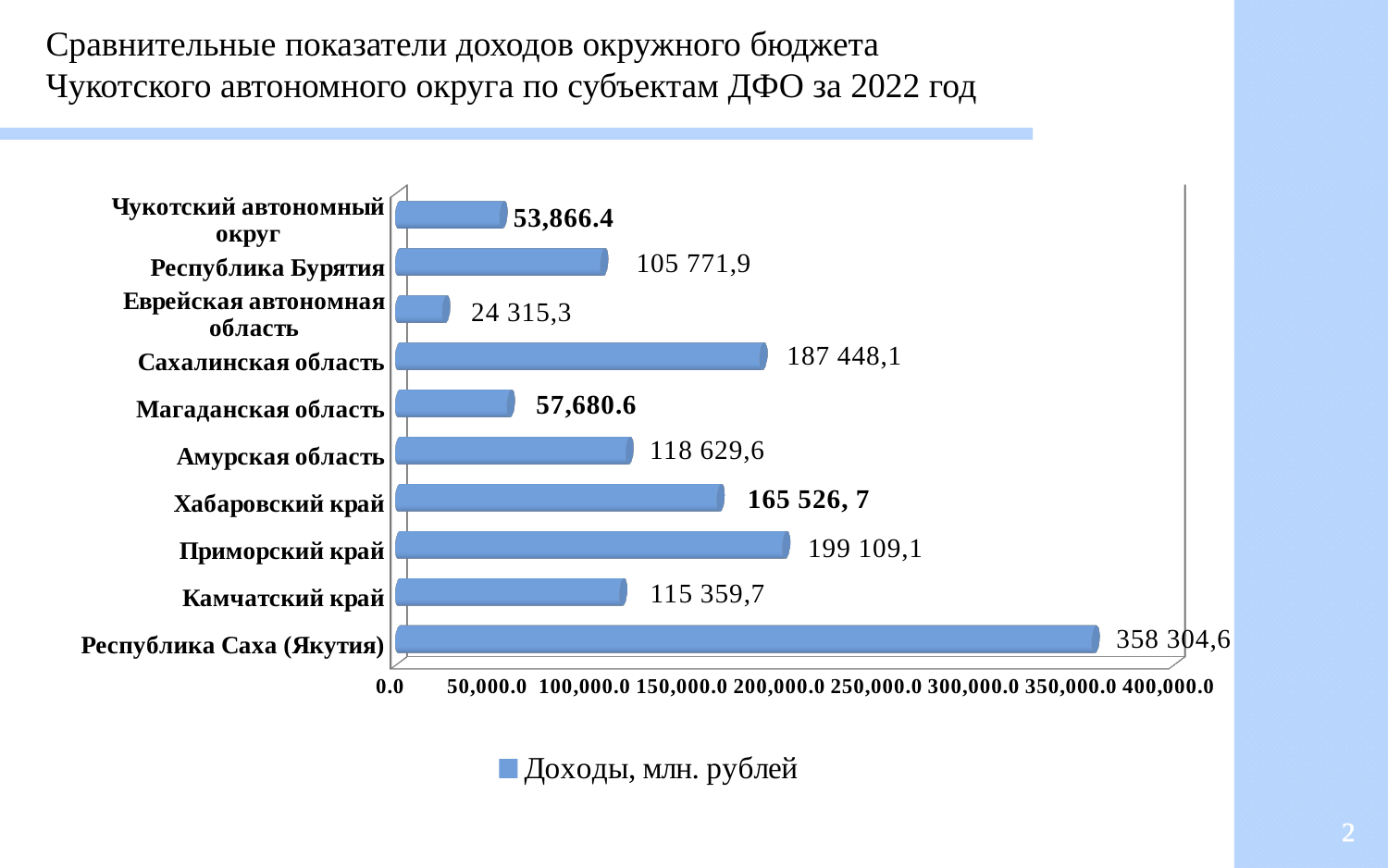
Which category has the lowest value? Еврейская автономная область Which is larger, the value for Приморский край or the value for Хабаровский край? Приморский край Which category has the highest value? Республика Саха (Якутия) How many categories are shown in the chart? 10 What series name does the legend show? Доходы, млн. рублей What is the difference between the values for Амурская область and Камчатский край? 3 269,9 What is the value for Сахалинская область? 187 448,1 What kind of chart is shown on the slide? bar chart Is the value for Магаданская область greater or less than 100,000.0? less What is the value for Еврейская автономная область? 24 315,3 What is the value for Республика Саха (Якутия)? 358 304,6 What is the value for Чукотский автономный округ? 53,866.4